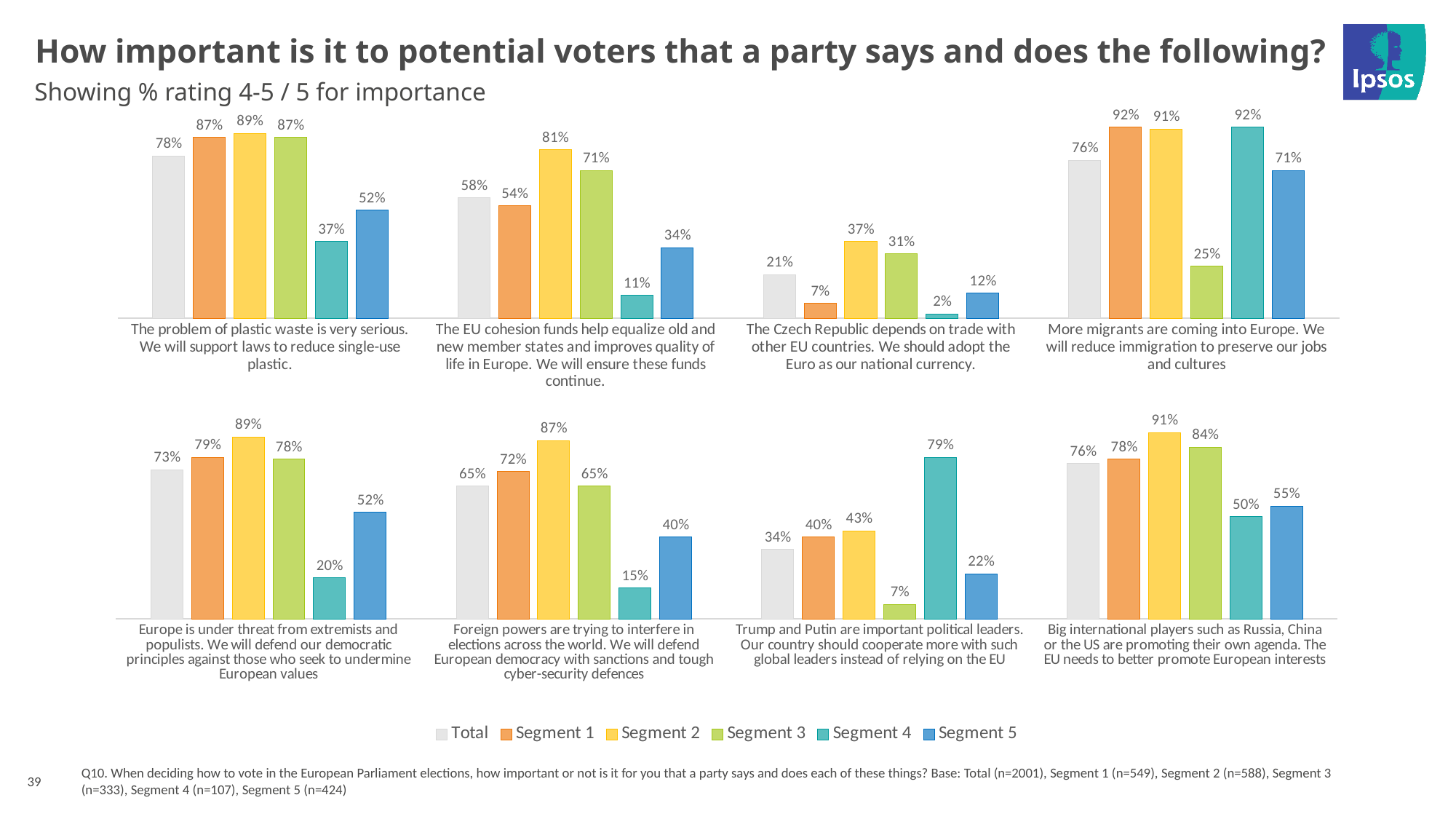
How many series does the legend list? 6 Which segment has the lowest value for the statement about the EU cohesion funds? Segment 4 What is the Segment 3 value for the statement 'Big international players such as Russia, China or the US are promoting their own agenda. The EU needs to better promote European interests'? 84% What is the Total value for the statement 'The problem of plastic waste is very serious. We will support laws to reduce single-use plastic.'? 78% For the statement 'Europe is under threat from extremists and populists...', which is larger: the Segment 1 value or the Segment 3 value? Segment 1 What is the difference between the Segment 2 and Segment 4 values for the statement 'Foreign powers are trying to interfere in elections across the world...'? 72 percentage points Which series in the legend is shown in grey? Total Which segment has the highest value for the statement 'More migrants are coming into Europe. We will reduce immigration to preserve our jobs and cultures'? Segment 1 and Segment 4 (both 92%) What is the Segment 5 value for the statement about the Czech Republic adopting the Euro as its national currency? 12% How many statements (categories) are shown in the chart? 8 What kind of chart is shown on the slide? Bar chart What is the Segment 4 value for the statement 'Trump and Putin are important political leaders. Our country should cooperate more with such global leaders instead of relying on the EU'? 79%